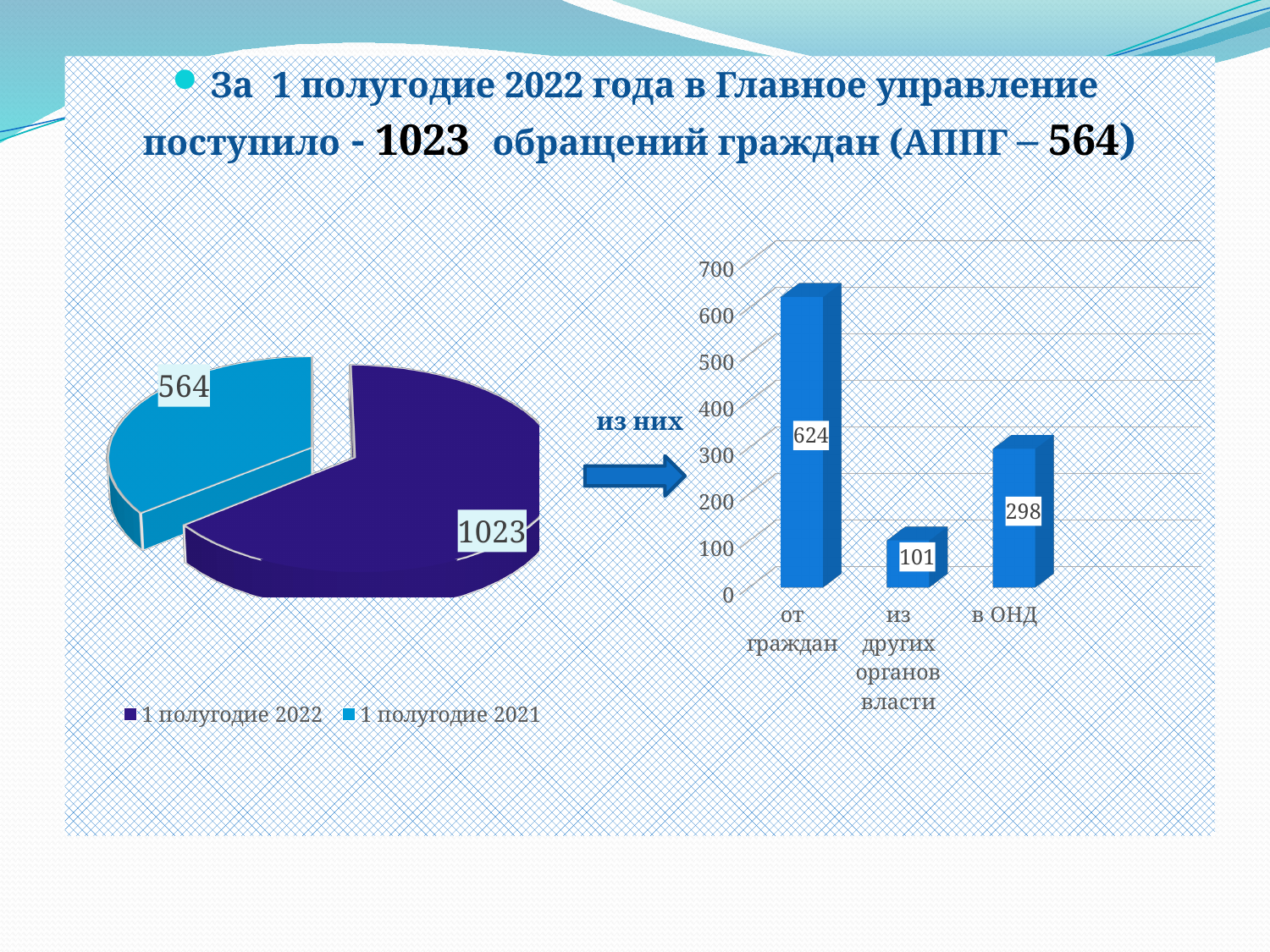
In the bar chart on the right, how many categories are shown on the x axis? 3 In the bar chart on the right, which category has the lowest value? из других органов власти In the bar chart on the right, what is the value for от граждан? 624 How many entries does the legend of the pie chart on the left list? 2 In the pie chart on the left, what value is shown for 1 полугодие 2022? 1023 What kind of chart is the chart on the left of the slide? pie chart In the pie chart on the left, what is the difference between the values for 1 полугодие 2022 and 1 полугодие 2021? 459 In the pie chart on the left, what value is shown for 1 полугодие 2021? 564 In the bar chart on the right, which category has the highest value? от граждан In the bar chart on the right, what is the value for в ОНД? 298 In the bar chart on the right, what is the value for из других органов власти? 101 In the pie chart on the left, which slice is larger, 1 полугодие 2022 or 1 полугодие 2021? 1 полугодие 2022